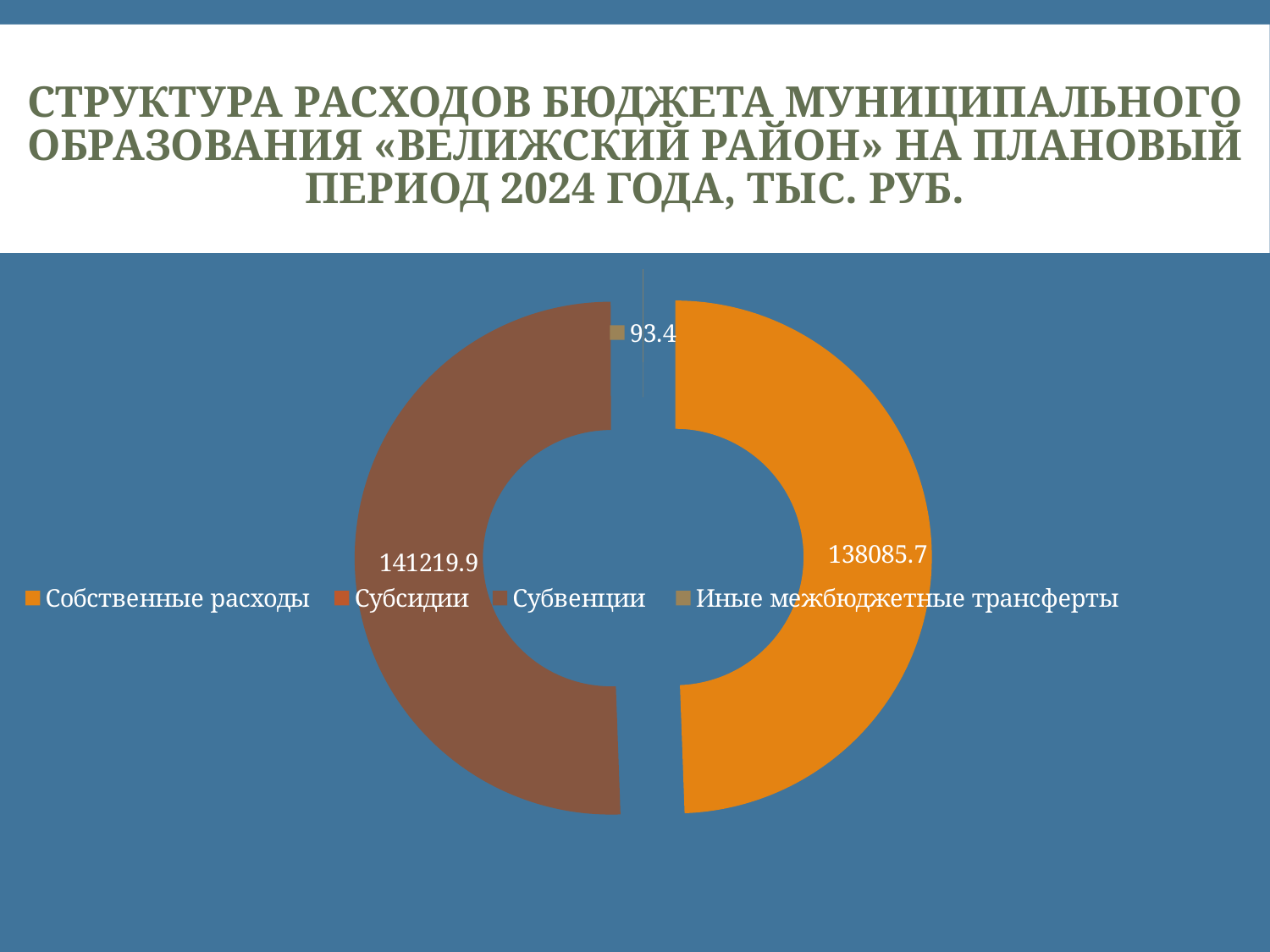
In what units are the values in the chart given, according to the slide title? тыс. руб. How many entries does the legend list? 4 What type of chart is shown on the slide? Doughnut (pie) chart What is the value for Субвенции? 141219.9 What is the difference between the values for Субвенции and Собственные расходы? 3134.2 Which category is shown in orange? Собственные расходы Which is larger, Собственные расходы or Субвенции? Субвенции Which category has the largest value in the chart? Субвенции What is the value for Собственные расходы? 138085.7 What is the value for Иные межбюджетные трансферты? 93.4